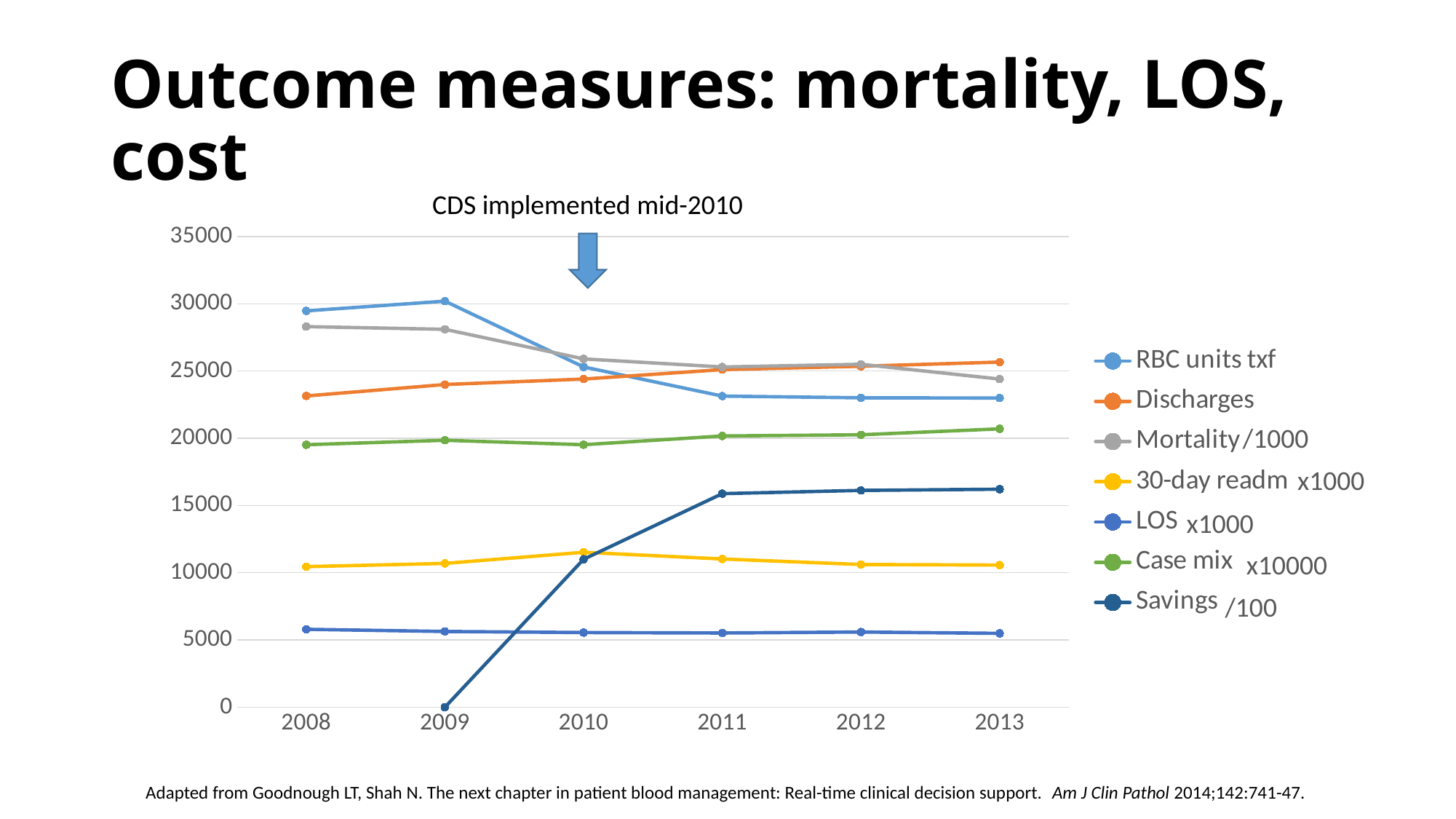
Which series has the highest value in 2008? RBC units txf Does the RBC units txf series rise or fall from 2008 to 2013? fall Is the value for LOS x1000 in 2008 greater or less than 10000? less What event does the annotation above the chart say happened in mid-2010? CDS implemented Is the value for RBC units txf in 2008 greater or less than 25000? greater How many series does the legend list? 7 What kind of chart is shown on the slide? line chart How many years are shown on the x axis? 6 In 2013, which is larger: RBC units txf or Discharges? Discharges What is the value for Savings /100 in 2009? 0 Which series has the lowest value in 2013? LOS x1000 Is the value for Savings /100 in 2011 greater or less than 15000? greater